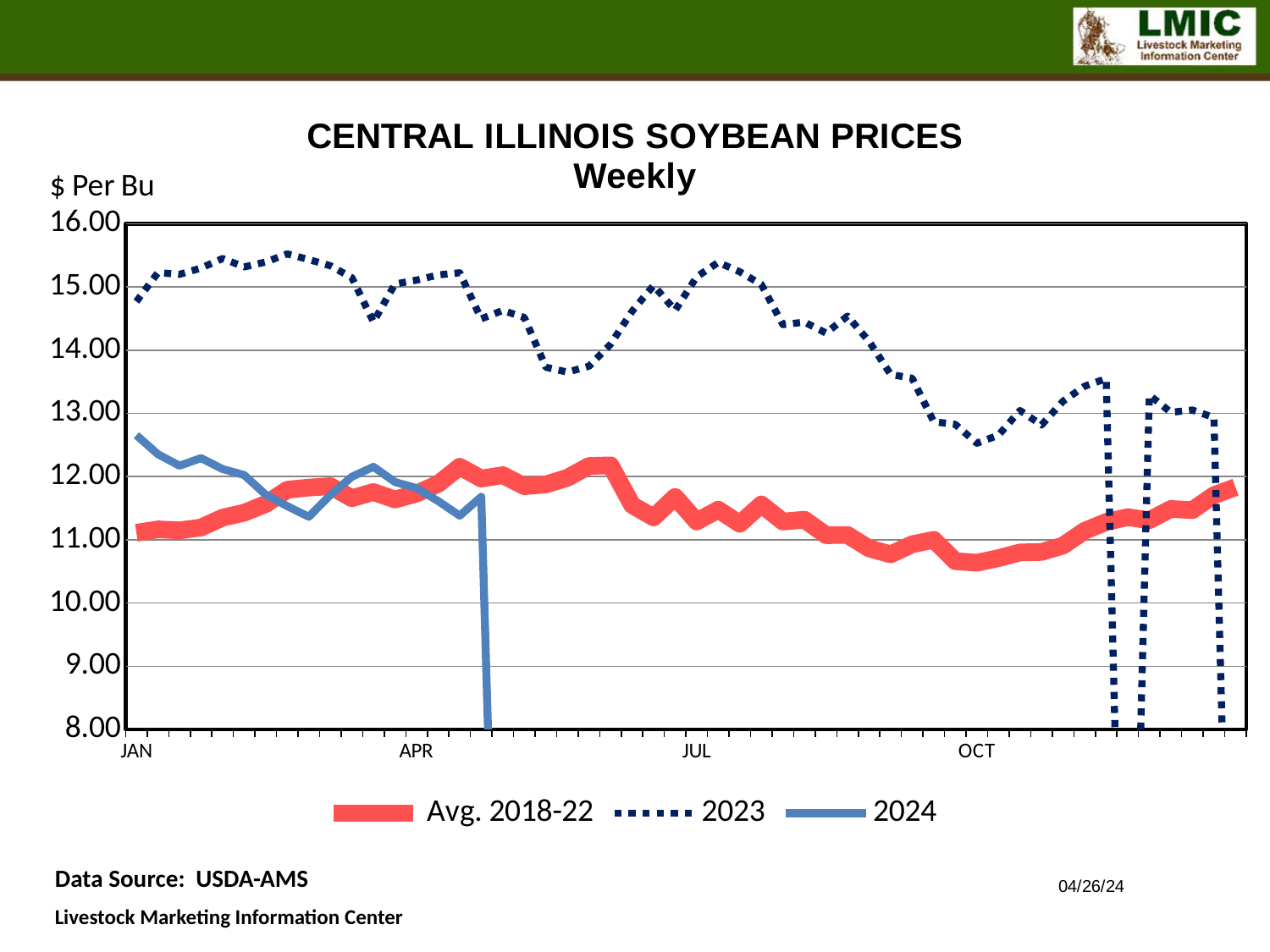
Does the 2023 series generally rise or fall from JAN to OCT? fall Is the Avg. 2018-22 value in January greater or less than 12.00? less Is the Avg. 2018-22 value at OCT greater or less than 11.00? less What is the title of the chart? CENTRAL ILLINOIS SOYBEAN PRICES Weekly What kind of chart is shown on the slide? Line chart In January, which series has the higher value, 2023 or 2024? 2023 Is the 2023 value in January greater or less than 14.00? greater How many month labels are shown on the x axis? 4 How many series does the legend list? 3 What unit is shown on the y axis label? $ Per Bu